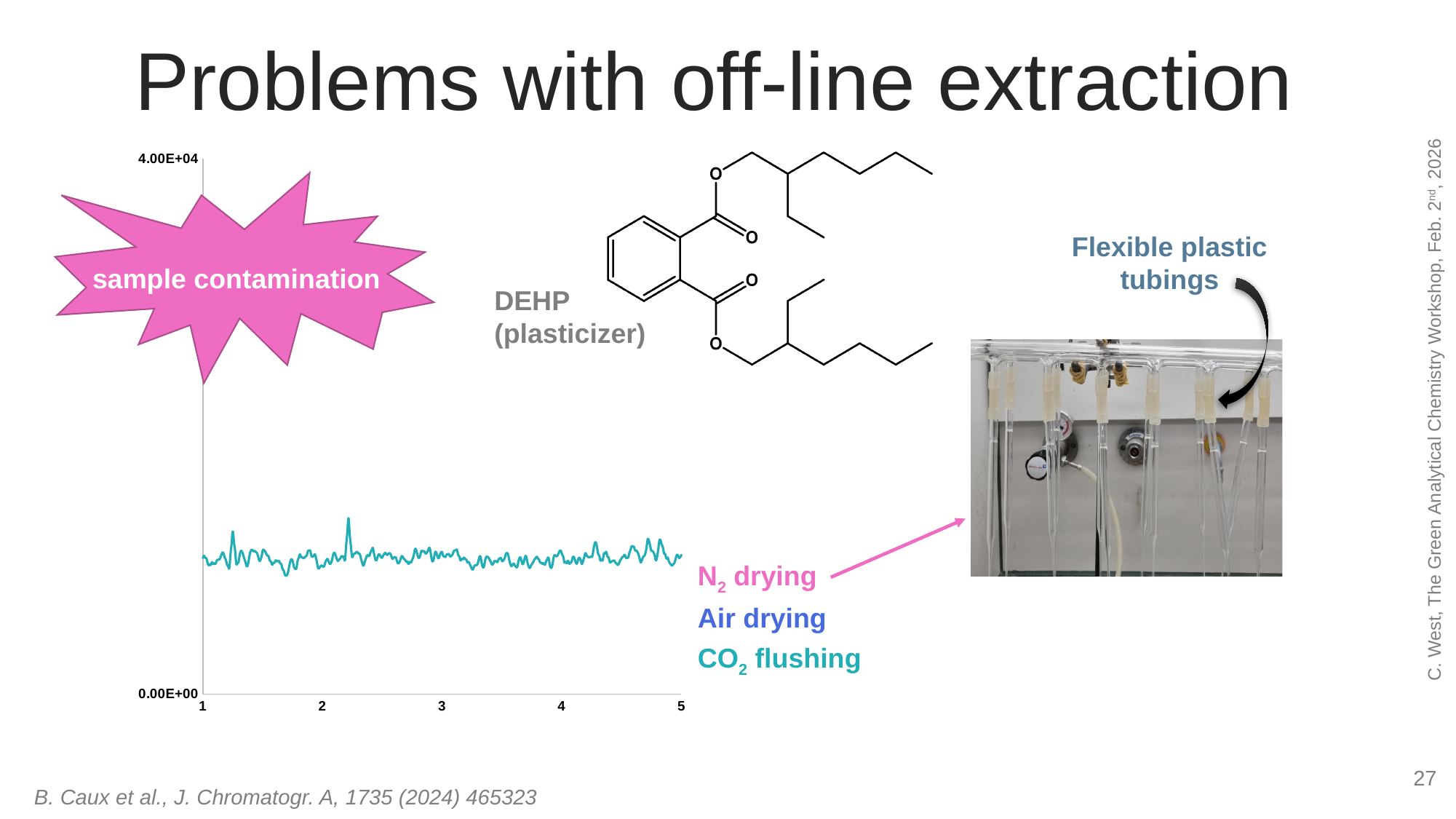
What kind of chart is shown on the left of the slide? line chart Does the CO2 flushing trace show a clear rising or falling trend from x = 1 to x = 5? no, it stays roughly flat Is the CO2 flushing trace greater or less than 4.00E+04 across the chart? less How many drying/flushing conditions are listed next to the chart? 3 How many tick labels are shown along the x axis of the chart? 5 What is the minimum value labelled on the y axis of the chart? 0.00E+00 What colour is the CO2 flushing trace plotted in? teal What is the first tick label on the x axis of the chart? 1 What is the maximum value labelled on the y axis of the chart? 4.00E+04 What is the last tick label on the x axis of the chart? 5